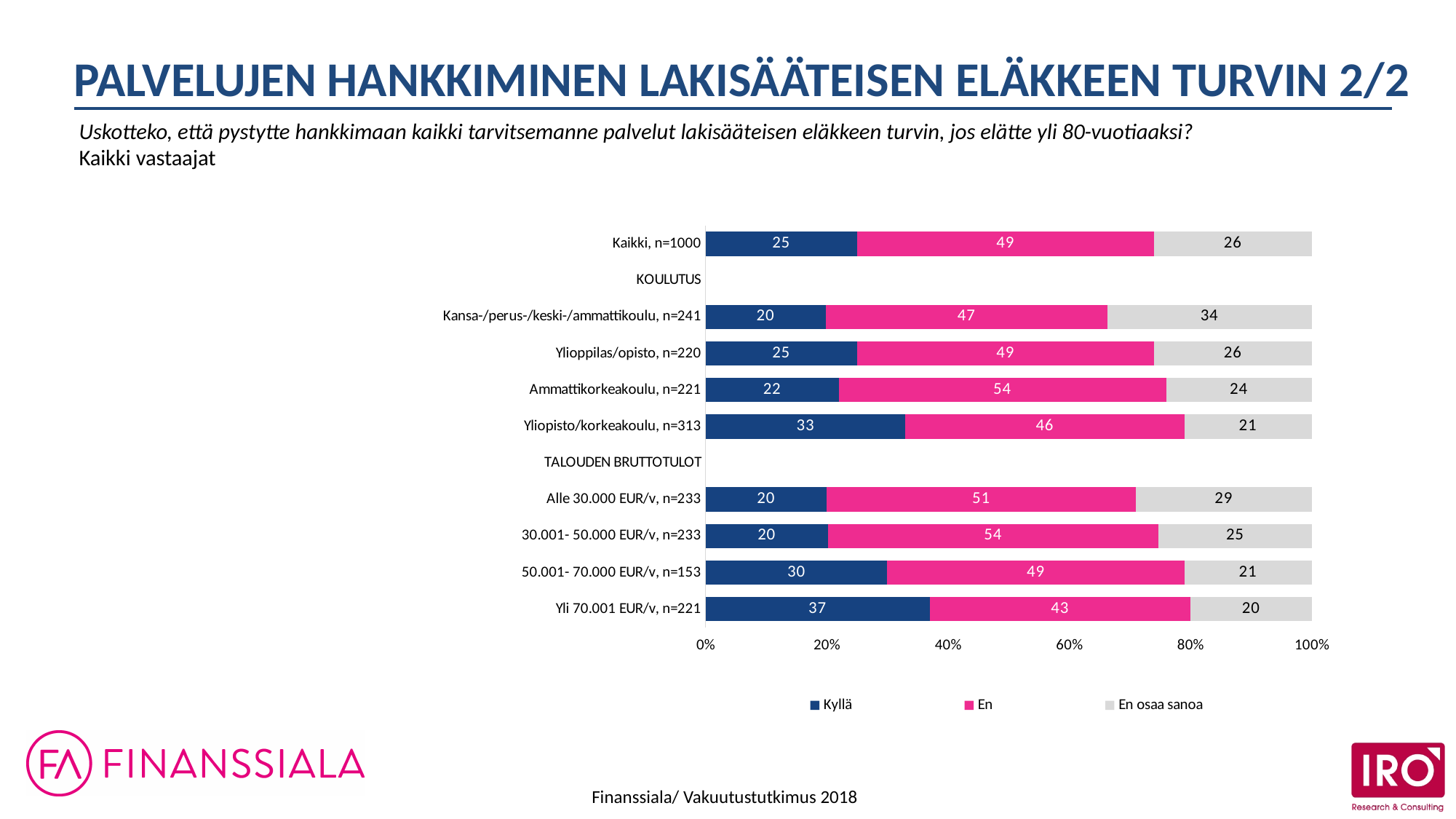
Which category has the lowest En value? Yli 70.001 EUR/v, n=221 What is the difference between the Kyllä value for Yli 70.001 EUR/v, n=221 and the Kyllä value for Alle 30.000 EUR/v, n=233? 17 What is the Kyllä value for Kaikki, n=1000? 25 What is the En value for Ammattikorkeakoulu, n=221? 54 Which category has the highest Kyllä value? Yli 70.001 EUR/v, n=221 Which category has the highest En osaa sanoa value? Kansa-/perus-/keski-/ammattikoulu, n=241 What is the Kyllä value for Yli 70.001 EUR/v, n=221? 37 What kind of chart is shown on the slide? Stacked bar chart How many series does the legend list? 3 Which has the larger Kyllä value: Yliopisto/korkeakoulu, n=313 or Ammattikorkeakoulu, n=221? Yliopisto/korkeakoulu, n=313 What is the En osaa sanoa value for Kansa-/perus-/keski-/ammattikoulu, n=241? 34 How many categories have bars plotted in the chart? 9